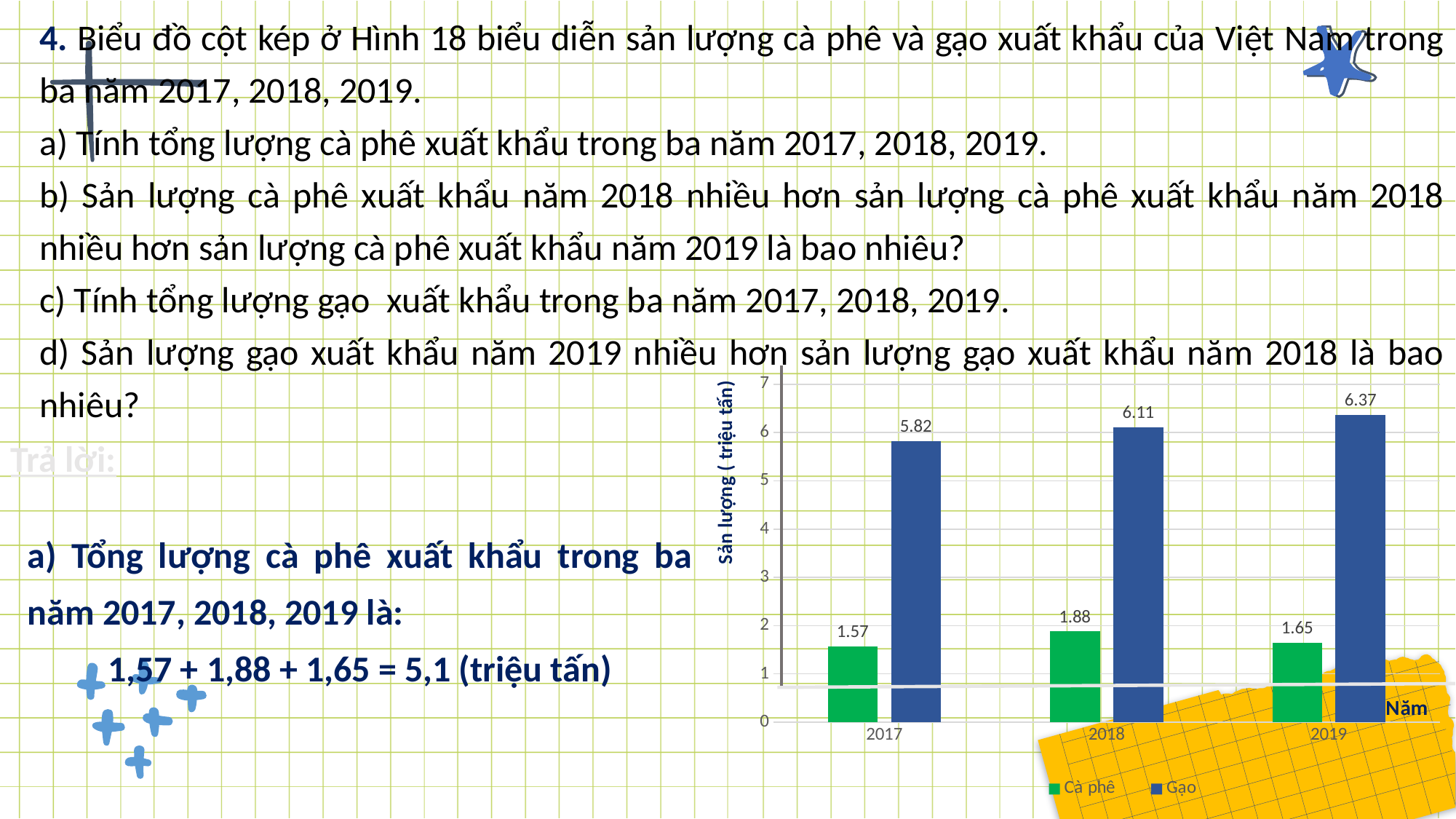
How many years are shown on the x axis? 3 What is the value for Cà phê in 2017? 1.57 Which is larger: the Gạo value for 2017 or the Gạo value for 2018? 2018 What is the difference between the Cà phê values for 2018 and 2019? 0.23 Is the value for Gạo in 2017 greater or less than 5? greater What is the value for Gạo in 2019? 6.37 What is the difference between the Gạo values for 2019 and 2018? 0.26 In which year is the Cà phê value lowest? 2017 How many series does the legend list? 2 What kind of chart is shown on the slide? Bar chart What is the value for Cà phê in 2018? 1.88 In which year is the Gạo value highest? 2019